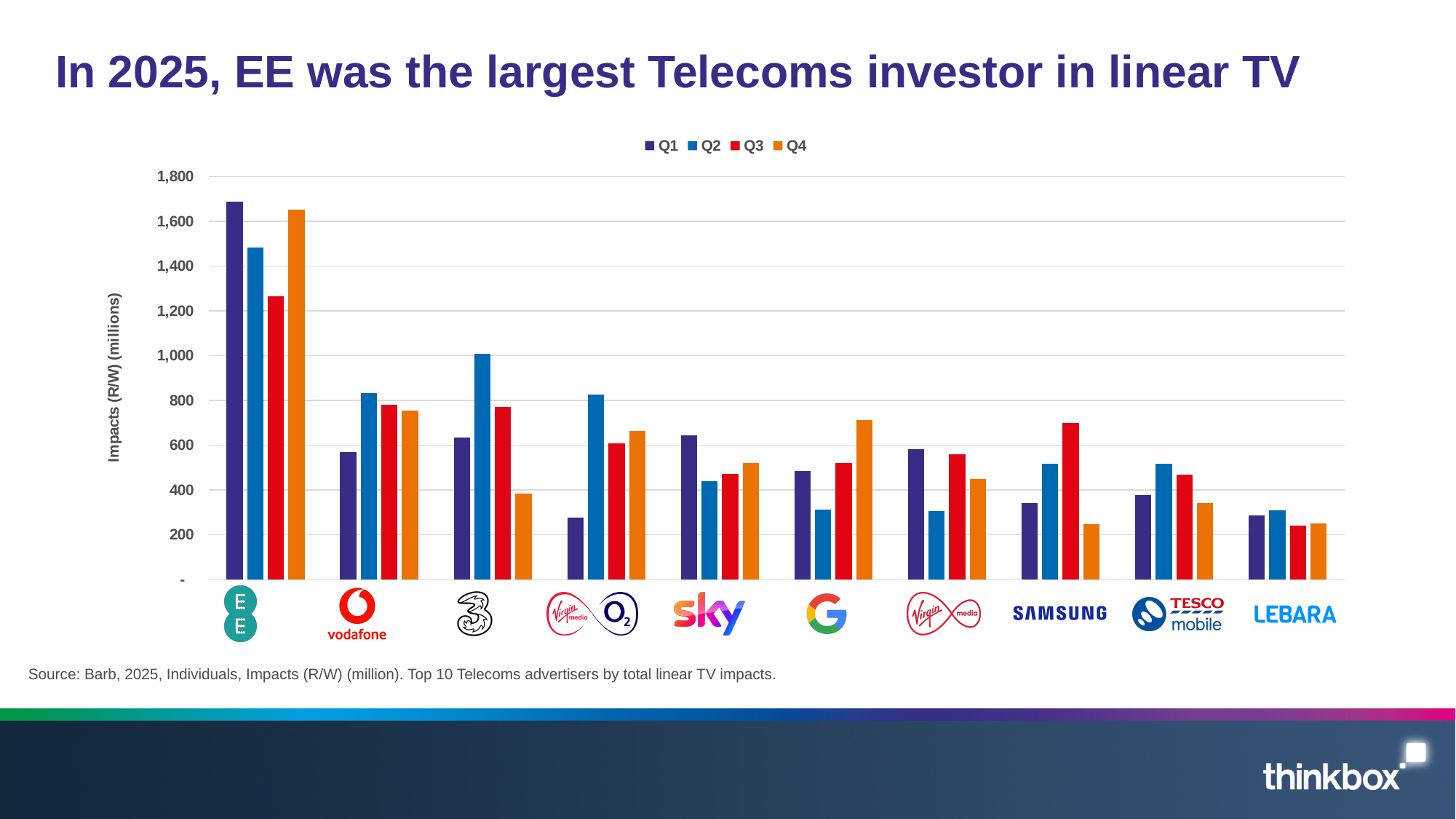
For Samsung, which is larger: the Q3 value or the Q4 value? Q3 For Google, which is larger: the Q1 value or the Q4 value? Q4 What is the title of the y axis? Impacts (R/W) (millions) What kind of chart is shown on the slide? Bar chart Which advertiser has the tallest Q1 bar? EE For EE, which quarter has the lowest value? Q3 How many series does the legend list? 4 How many advertisers are shown along the x axis? 10 For Three, which quarter has the highest value? Q2 Is the Q1 value for Lebara greater or less than 400? less Is the Q1 value for Virgin Media O2 greater or less than 400? less Is the Q1 value for EE greater or less than 1,600? greater